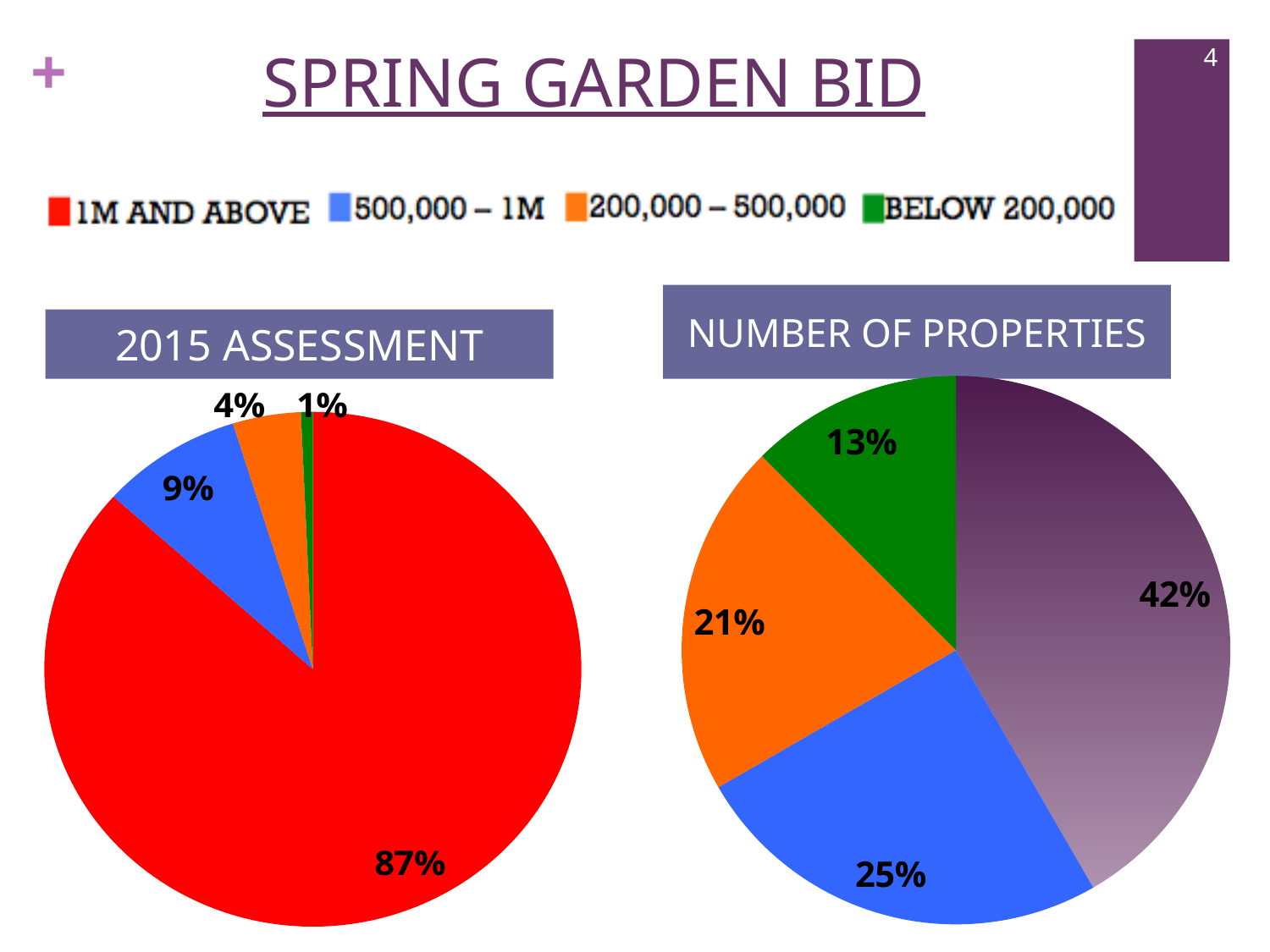
In the 2015 ASSESSMENT chart, what share does the BELOW 200,000 category have? 1% In the 2015 ASSESSMENT chart, which category has the smallest slice? BELOW 200,000 What kind of chart is the 2015 ASSESSMENT chart? Pie chart In the NUMBER OF PROPERTIES chart, what is the share of the largest slice? 42% How many categories does the legend list? 4 In the 2015 ASSESSMENT chart, what share does the 1M AND ABOVE category have? 87% In the NUMBER OF PROPERTIES chart, what share does the BELOW 200,000 category have? 13% Which is larger: the 200,000 – 500,000 share in the 2015 ASSESSMENT chart or in the NUMBER OF PROPERTIES chart? NUMBER OF PROPERTIES In the NUMBER OF PROPERTIES chart, what is the difference between the 500,000 – 1M share and the BELOW 200,000 share? 12%